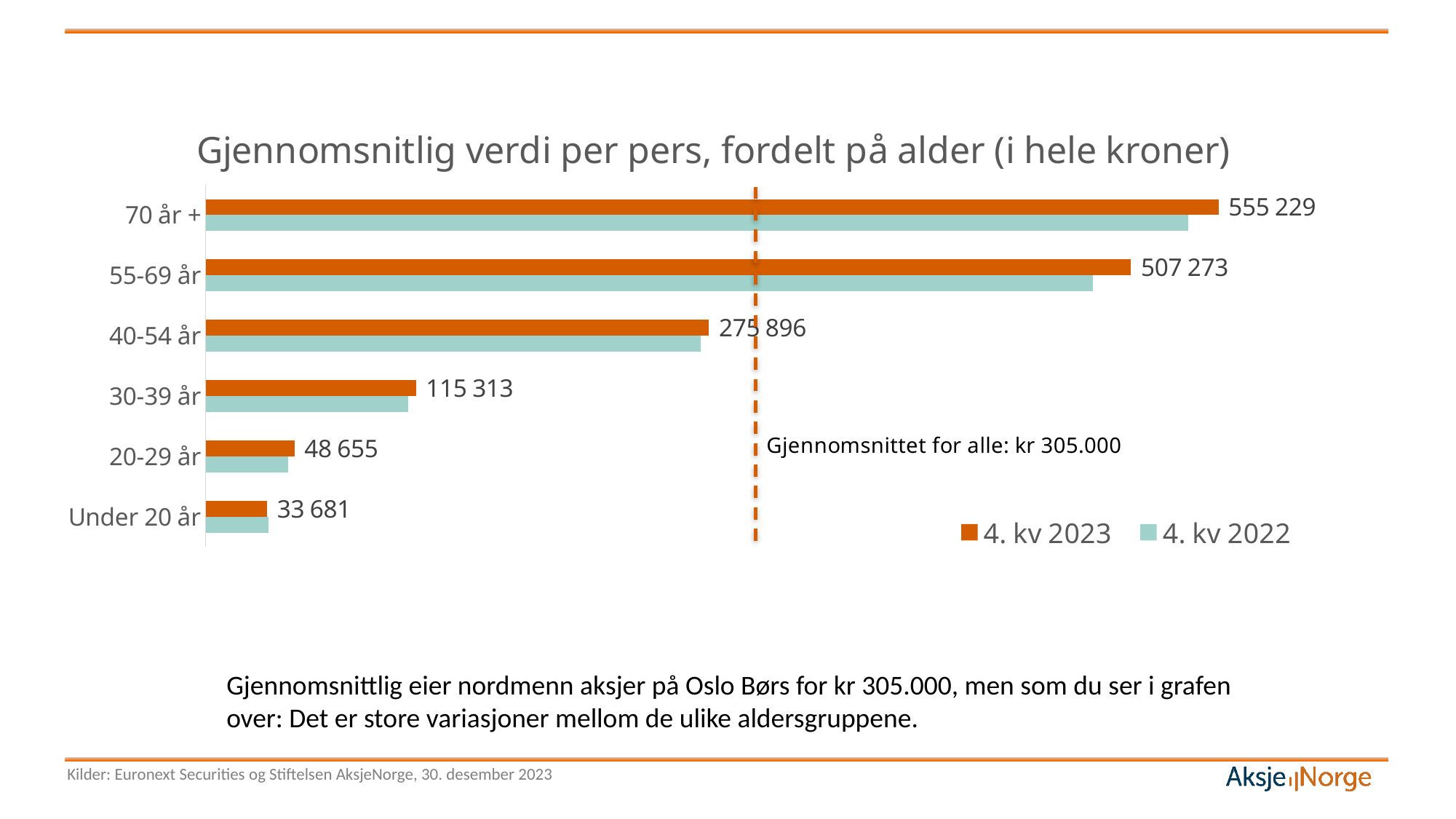
What is the 4. kv 2023 value for the Under 20 år age group? 33 681 What is the difference between the 4. kv 2023 values for 70 år + and 55-69 år? 47 956 Which age group has the highest 4. kv 2023 value? 70 år + How many series does the legend list? 2 For the 55-69 år age group, which is larger: the 4. kv 2023 value or the 4. kv 2022 value? 4. kv 2023 What is the 4. kv 2023 value for the 30-39 år age group? 115 313 Which age group has the lowest 4. kv 2023 value? Under 20 år What is the difference between the 4. kv 2023 values for 20-29 år and Under 20 år? 14 974 What is the 4. kv 2023 value for the 70 år + age group? 555 229 What is the 4. kv 2023 value for the 40-54 år age group? 275 896 How many age groups are shown in the chart? 6 Is the 4. kv 2022 value for 40-54 år greater or less than the average line of kr 305.000? less